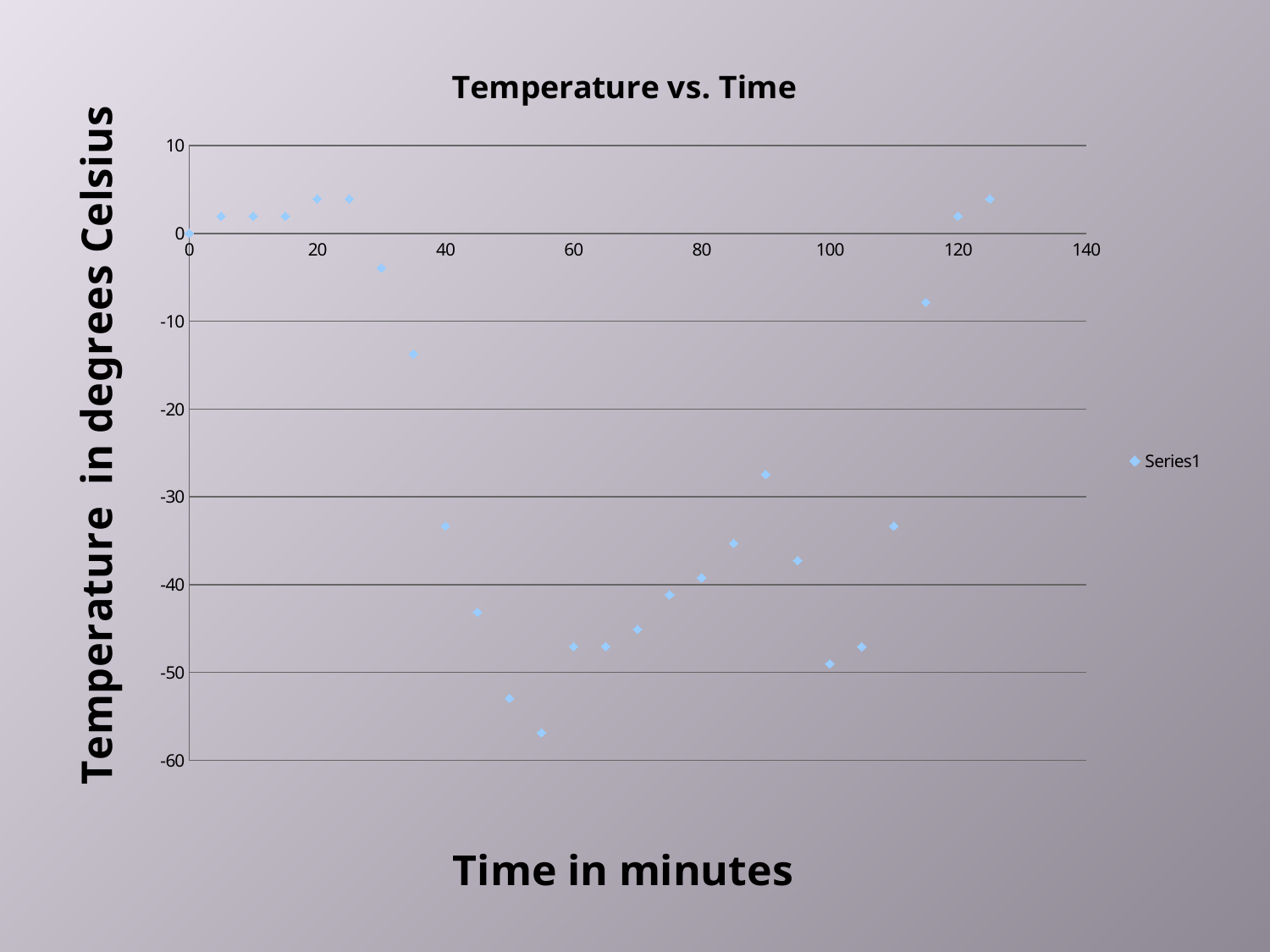
Is the temperature at 55 minutes greater or less than -50? less Between 30 and 55 minutes, do the plotted temperatures rise or fall? fall What kind of chart is shown on the slide? scatter chart Is the temperature at 115 minutes greater or less than 0? less What is the label of the x axis? Time in minutes What is the title of the chart? Temperature vs. Time Is the temperature at 100 minutes greater or less than -40? less How many series does the legend list? 1 Which is larger, the temperature at 20 minutes or the temperature at 40 minutes? 20 minutes